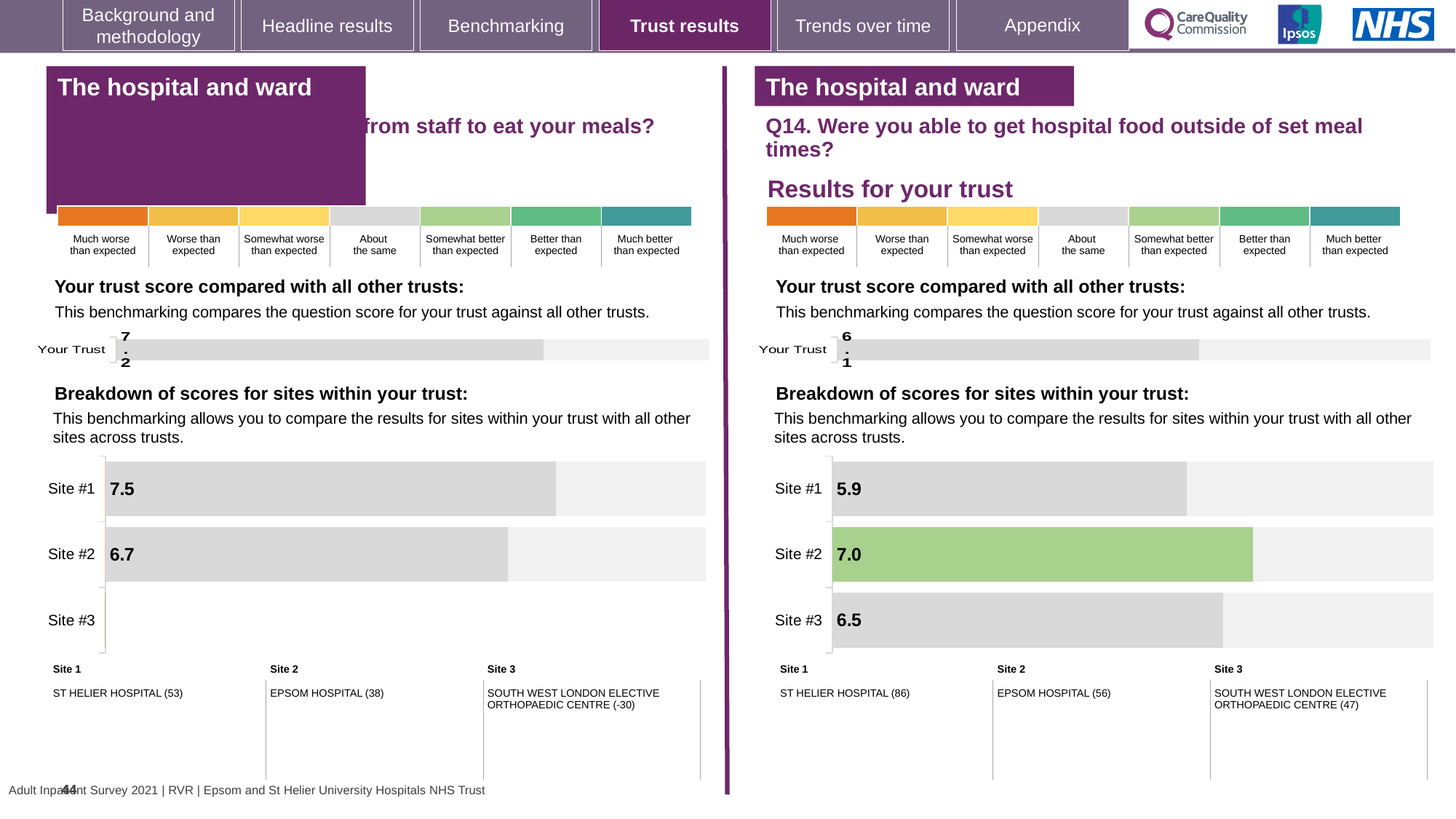
In the right-hand breakdown of scores for sites chart, which site has the highest score? Site #2 In the left-hand breakdown of scores for sites chart, which has the larger score, Site #1 or Site #2? Site #1 In the left-hand breakdown of scores for sites chart, what is the difference between the scores for Site #1 and Site #2? 0.8 On the right-hand Q14 chart, what is the score for Your Trust? 6.1 In the right-hand breakdown of scores for sites chart, which site has the lowest score? Site #1 On the left-hand chart, what is the score for Your Trust? 7.2 In the right-hand breakdown of scores for sites chart, what is the score for Site #1? 5.9 In the right-hand breakdown of scores for sites chart, what is the score for Site #2? 7.0 What type of chart is used for the breakdown of scores for sites within your trust? Bar chart In the right-hand breakdown of scores for sites chart, what is the difference between the scores for Site #2 and Site #3? 0.5 In the left-hand breakdown of scores for sites chart, what is the score for Site #1? 7.5 How many sites are listed in the right-hand breakdown of scores for sites chart? 3